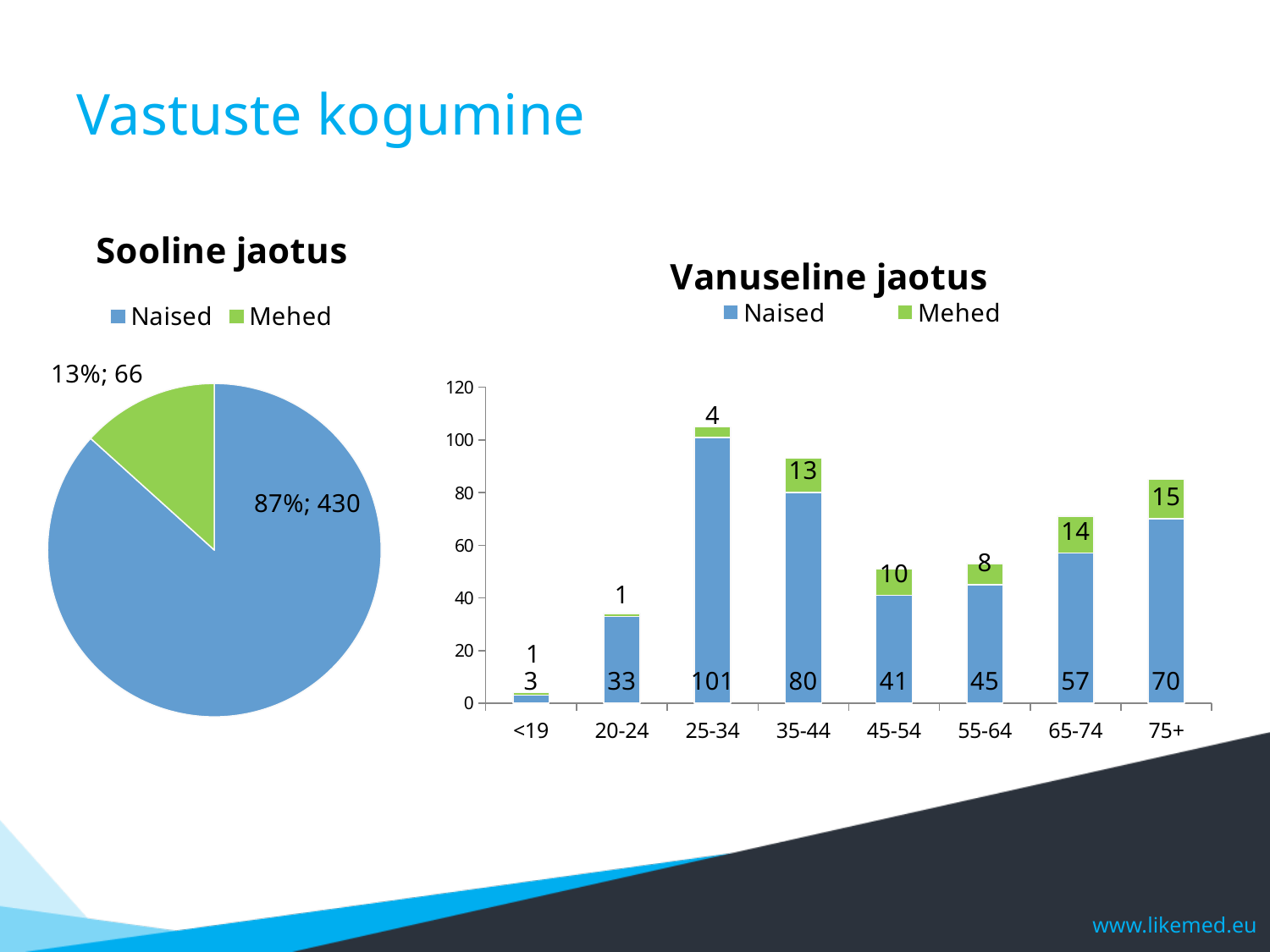
In the 'Vanuseline jaotus' chart, what is the difference between the Naised values for 75+ and 65-74? 13 In the 'Vanuseline jaotus' chart, which age group has the lowest Mehed value? <19 and 20-24 (tied at 1) In the 'Sooline jaotus' chart, what kind of chart is it? pie chart In the 'Vanuseline jaotus' chart, which age group has the highest Naised value? 25-34 In the 'Vanuseline jaotus' chart, how many series does the legend list? 2 In the 'Vanuseline jaotus' chart, what is the Mehed value for 65-74? 14 In the 'Vanuseline jaotus' chart, what kind of chart is it? stacked bar chart In the 'Vanuseline jaotus' chart, how many age groups are shown on the x axis? 8 In the 'Sooline jaotus' chart, what share of the pie is Naised? 87% In the 'Vanuseline jaotus' chart, what is the Naised value for 25-34? 101 In the 'Sooline jaotus' chart, what is the value for Mehed? 66 In the 'Vanuseline jaotus' chart, what is the total of the stacked bar for 35-44? 93